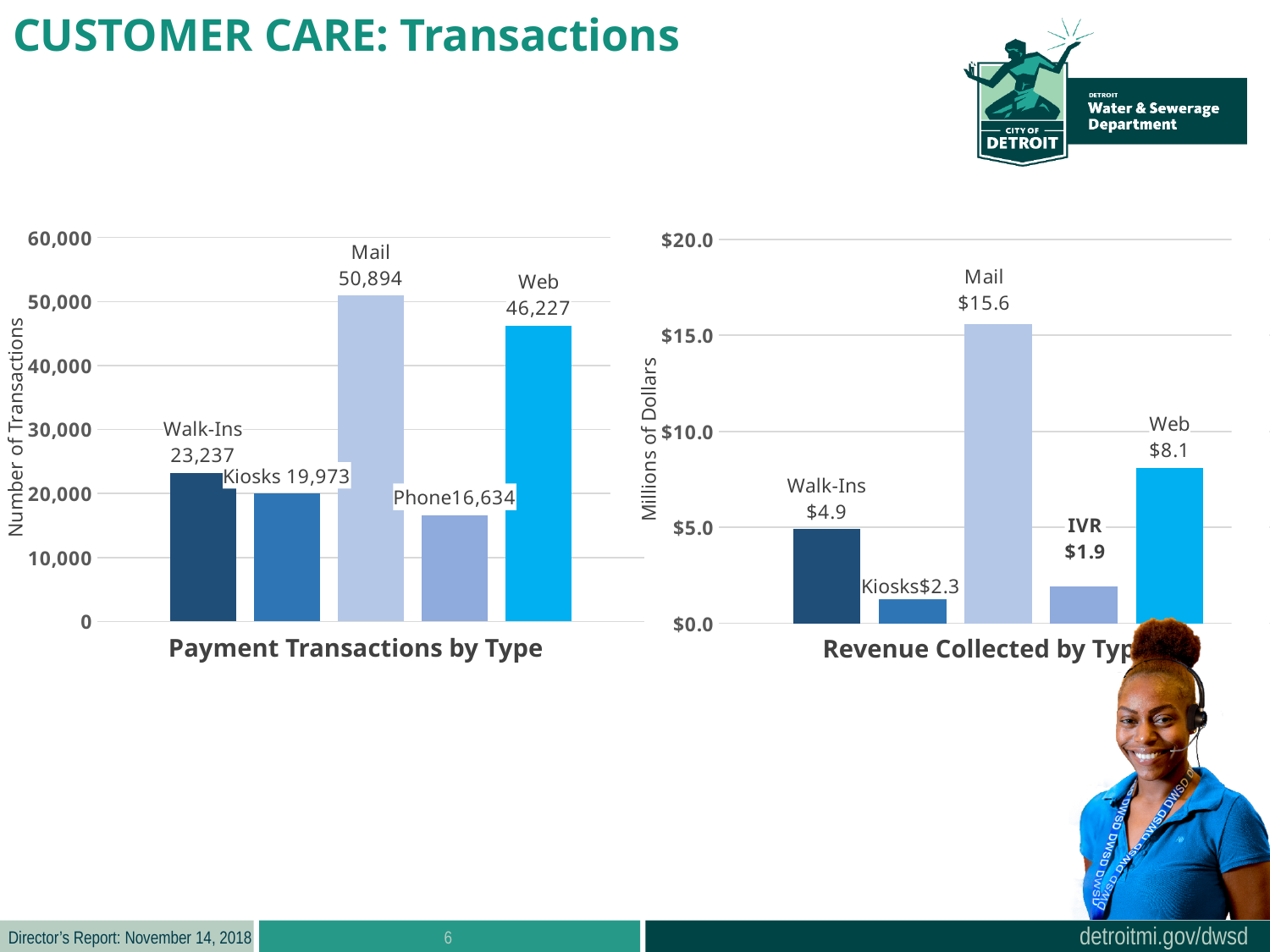
In the Payment Transactions by Type chart, which payment type has the highest number of transactions? Mail In the Revenue Collected by Type chart, what is the difference between the Mail and Web revenue? $7.5 In the Payment Transactions by Type chart, what is the difference between the Mail and Web transaction counts? 4,667 In the Revenue Collected by Type chart, how much revenue was collected through IVR? $1.9 In the Revenue Collected by Type chart, how much revenue was collected by Mail? $15.6 In the Payment Transactions by Type chart, which has more transactions, Walk-Ins or Kiosks? Walk-Ins In the Payment Transactions by Type chart, how many payment types are shown? 5 What kind of chart is the Revenue Collected by Type chart? Bar chart In the Revenue Collected by Type chart, which type collected the least revenue? IVR In the Payment Transactions by Type chart, which payment type has the lowest number of transactions? Phone In the Payment Transactions by Type chart, how many transactions were made by Mail? 50,894 In the Payment Transactions by Type chart, how many transactions were made by Phone? 16,634